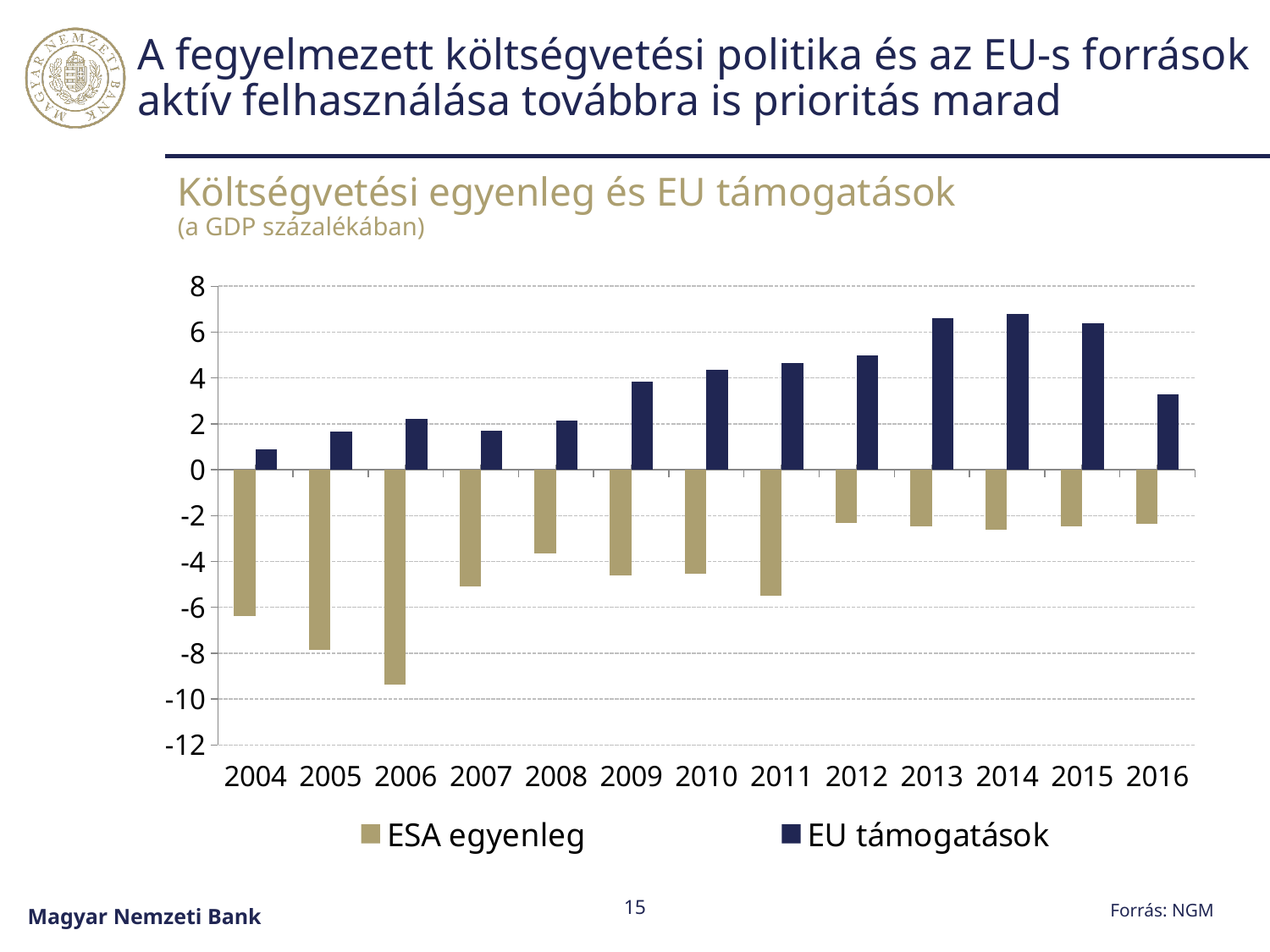
Is the value for ESA egyenleg in 2006 greater or less than -8? less Which is larger, the value for EU támogatások in 2010 or in 2005? 2010 How many years are shown on the x axis? 13 What is the title of the chart? Költségvetési egyenleg és EU támogatások Which year has the lowest value for EU támogatások? 2004 Is the value for EU támogatások in 2013 greater or less than 6? greater Which year has the lowest value for ESA egyenleg? 2006 Do the values for EU támogatások rise or fall from 2004 to 2014? rise Is the value for ESA egyenleg in 2012 greater or less than -4? greater What kind of chart is shown on the slide? bar chart How many series does the legend list? 2